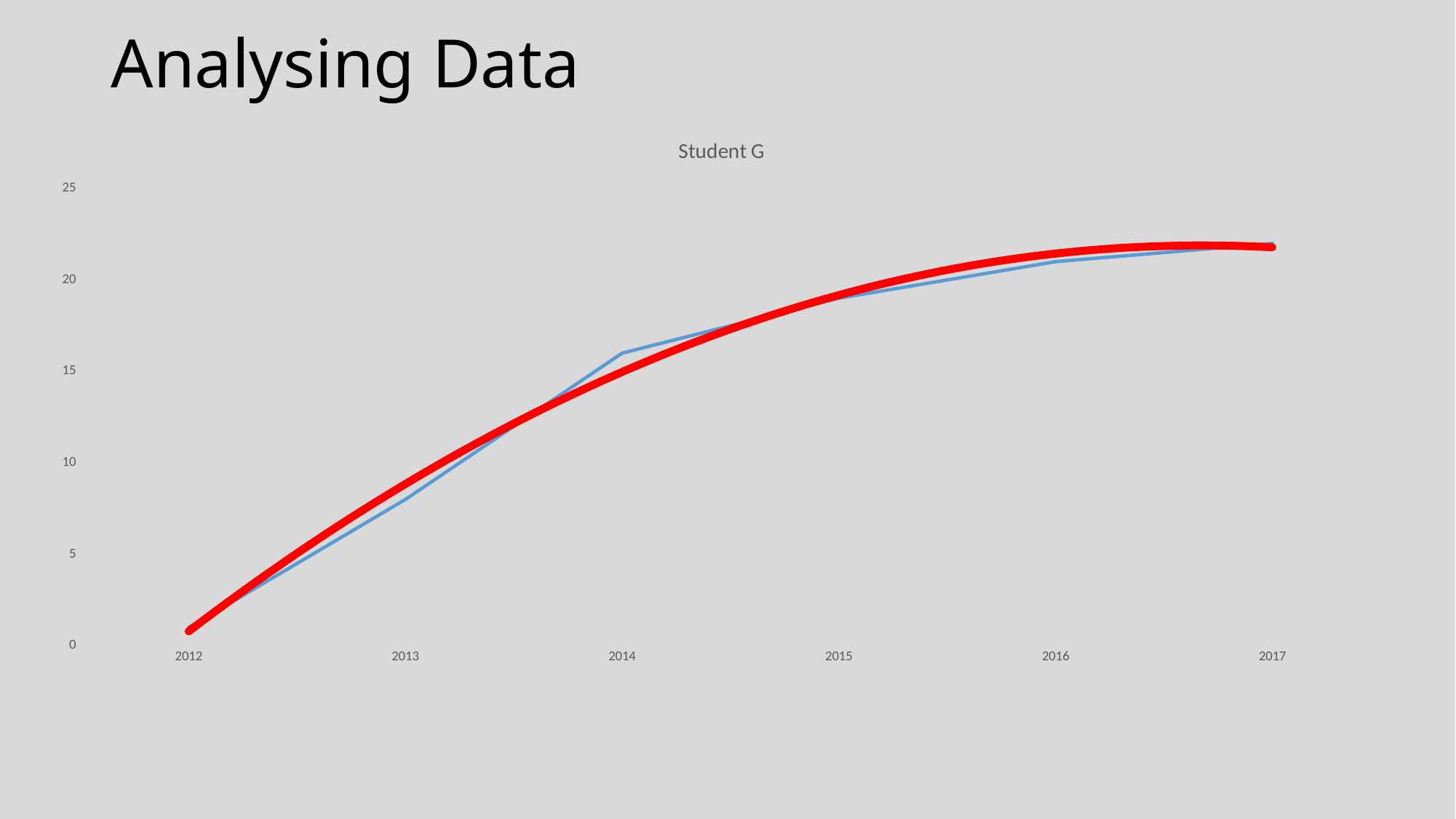
Is the value for 2017 greater or less than 20? greater Which year has the highest value in the chart? 2017 Is the value for 2014 greater or less than 15? greater Is the value for 2013 greater or less than 10? less Do the values in the chart rise or fall from 2012 to 2017? rise What is the highest value shown on the y axis of the chart? 25 Which year has the lowest value in the chart? 2012 What kind of chart is shown on the slide? line chart Which is larger, the value for 2013 or the value for 2015? 2015 What is the title of the chart? Student G How many years are shown on the x axis of the chart? 6